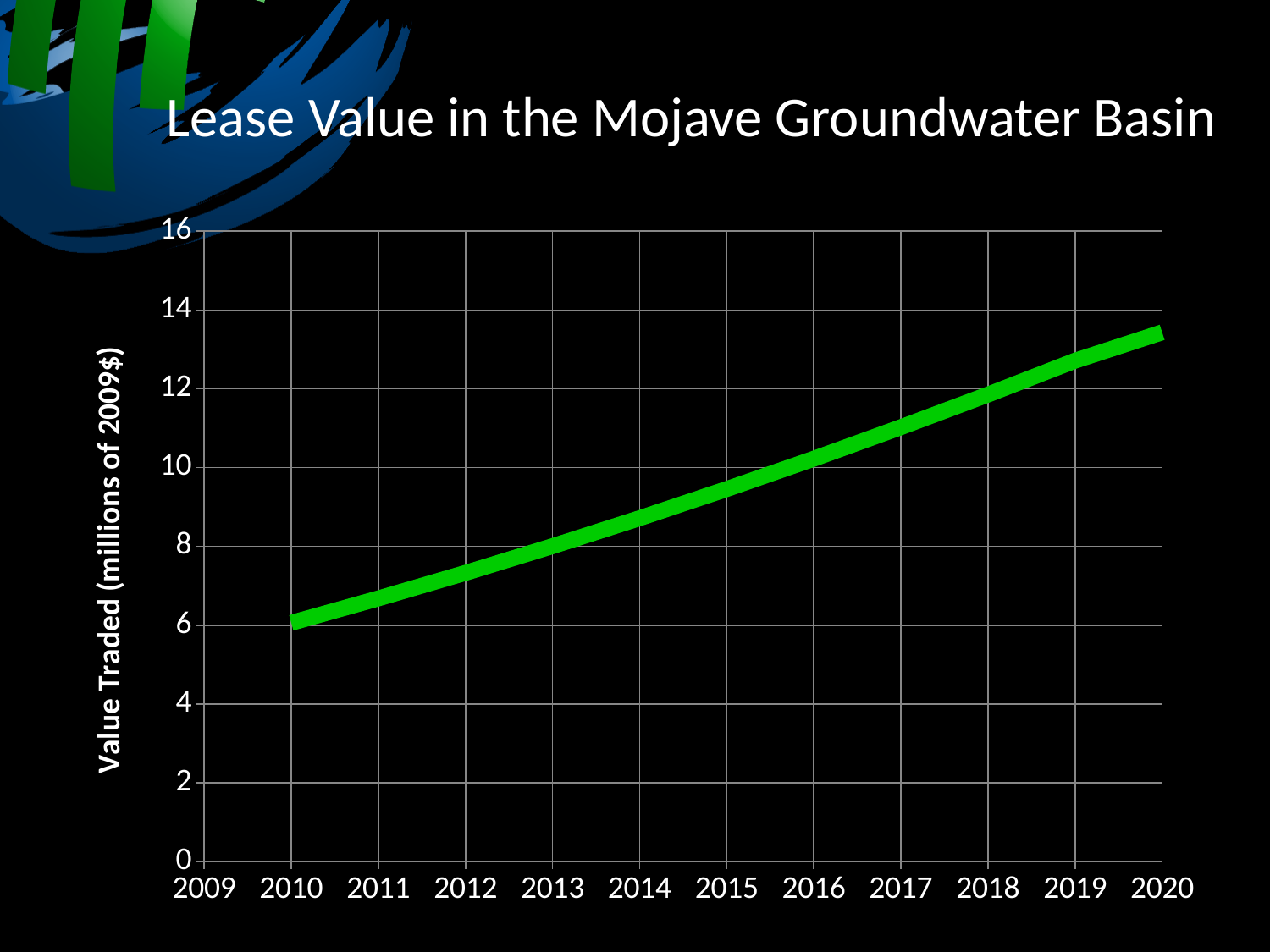
Is the value traded in 2020 greater or less than 14? less Is the value traded in 2017 greater or less than 10? greater In which year is the value traded highest? 2020 Is the value traded in 2010 greater or less than 8? less Does the value traded rise or fall from 2010 to 2020? rise What kind of chart is shown on the slide? line chart In which year is the value traded lowest? 2010 Which year has the larger value traded, 2010 or 2020? 2020 What is the label on the vertical axis of the chart? Value Traded (millions of 2009$) What is the title of the chart? Lease Value in the Mojave Groundwater Basin